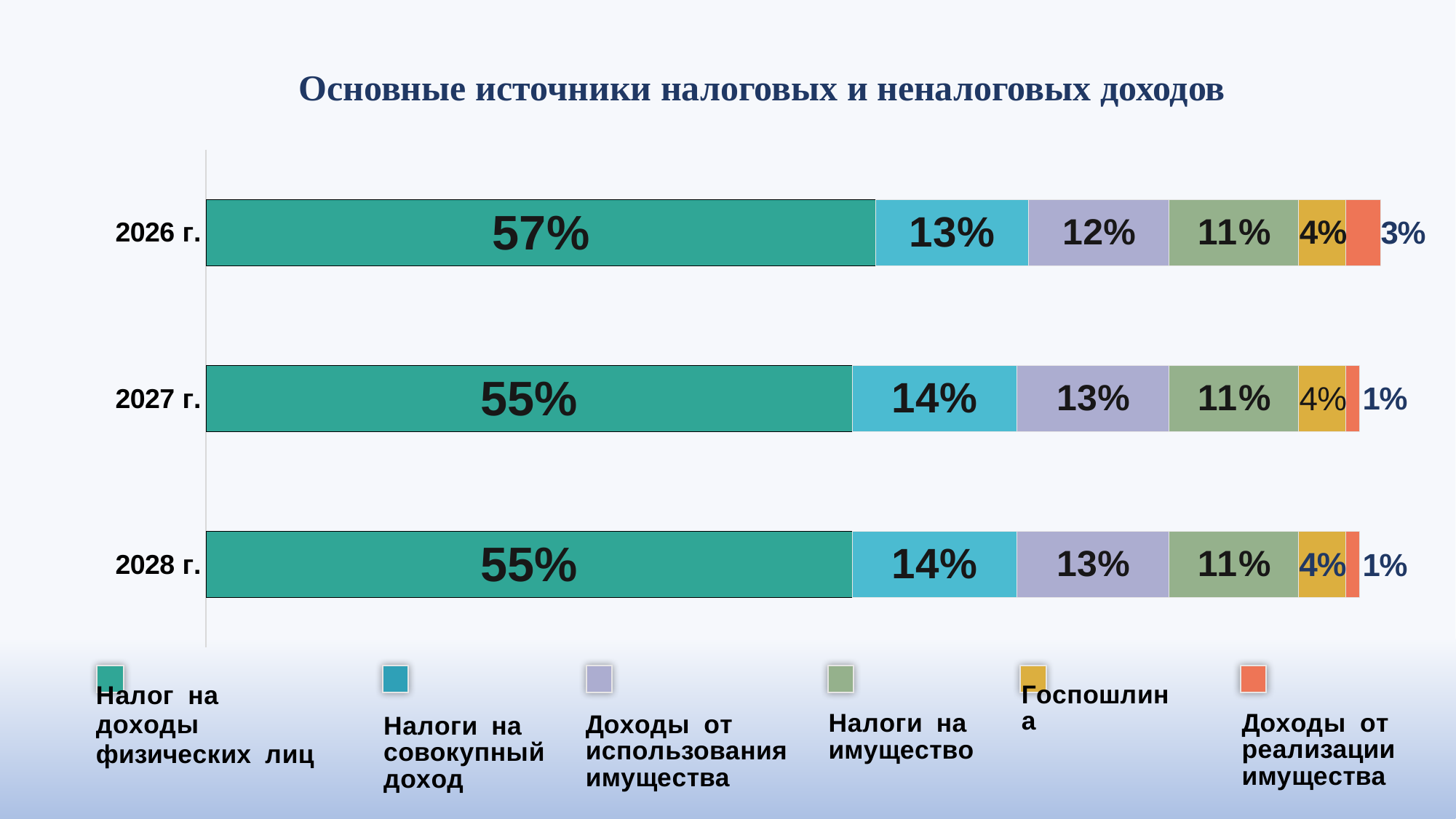
In which year is the share of Налог на доходы физических лиц the highest? 2026 г. What is the difference between the Налог на доходы физических лиц values for 2026 г. and 2027 г.? 2% In 2026 г., which is larger: Доходы от использования имущества or Налоги на имущество? Доходы от использования имущества What is the title of the chart? Основные источники налоговых и неналоговых доходов What is the value for Доходы от реализации имущества in 2026 г.? 3% What is the value for Налоги на совокупный доход in 2027 г.? 14% In which year is the share of Доходы от реализации имущества the highest? 2026 г. What kind of chart is shown on the slide? Stacked bar chart How many series does the legend list? 6 What is the value for Госпошлина in 2028 г.? 4% What is the value for Налог на доходы физических лиц in 2026 г.? 57% How many years are shown on the chart? 3